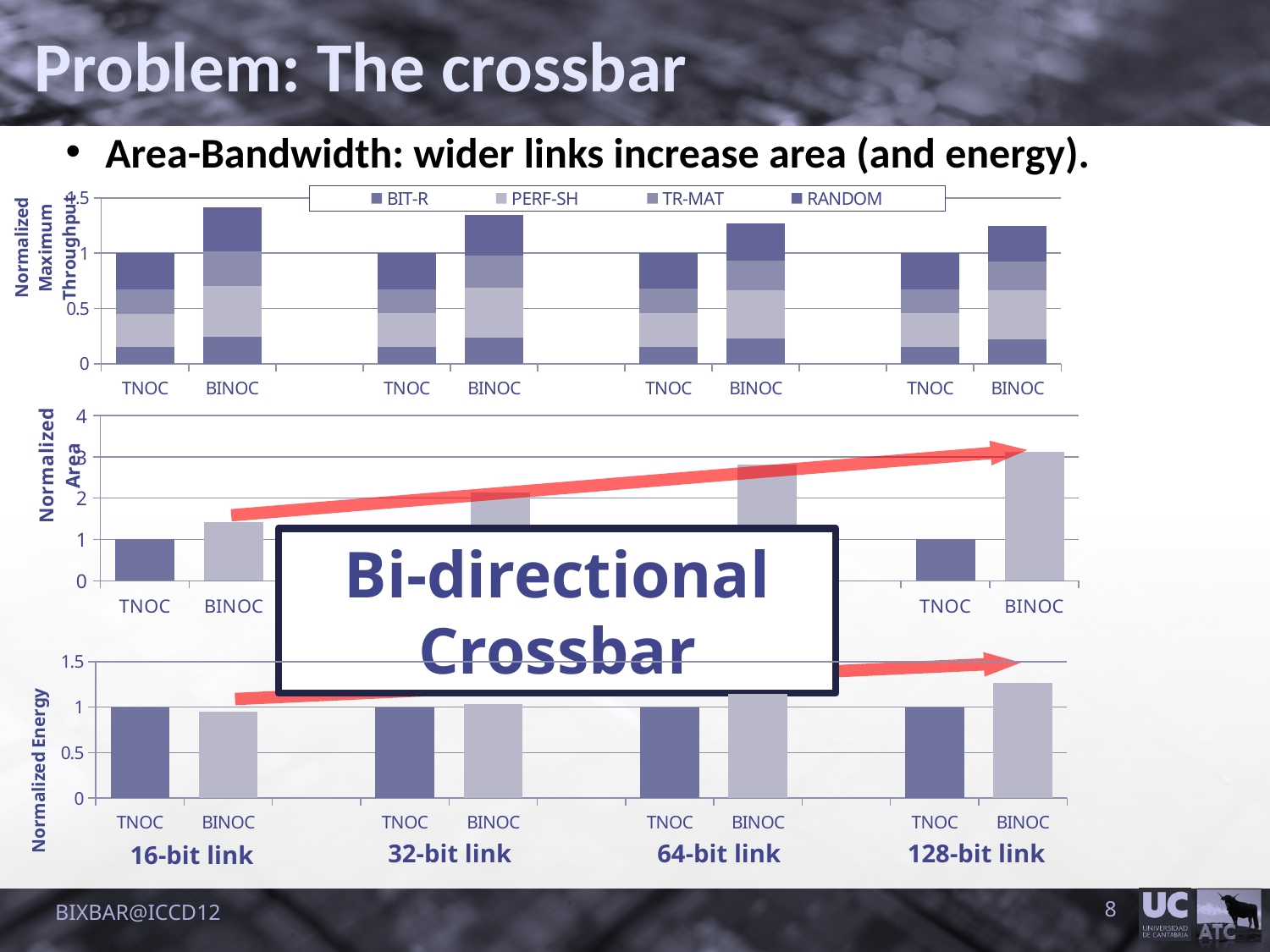
In the Normalized Area chart, what is the value for TNOC at the 16-bit link? 1 In the Normalized Energy chart, is the value for BINOC at the 128-bit link greater or less than 1.5? less What kind of chart is the Normalized Maximum Throughput chart at the top of the slide? stacked bar chart In the Normalized Maximum Throughput chart, is the total for BINOC at the 16-bit link greater or less than 1? greater In the Normalized Energy chart, which is larger at the 64-bit link, TNOC or BINOC? BINOC In the Normalized Area chart, is the value for BINOC at the 16-bit link greater or less than 2? less In the Normalized Area chart, which bar is the highest? BINOC at 128-bit link In the Normalized Maximum Throughput chart, how many series does the legend list? 4 In the Normalized Area chart, do the BINOC values rise or fall as the link width increases from 16-bit to 128-bit? rise In the Normalized Maximum Throughput chart, what are the legend entries? BIT-R, PERF-SH, TR-MAT, RANDOM How many link widths are compared across the charts on the slide? 4